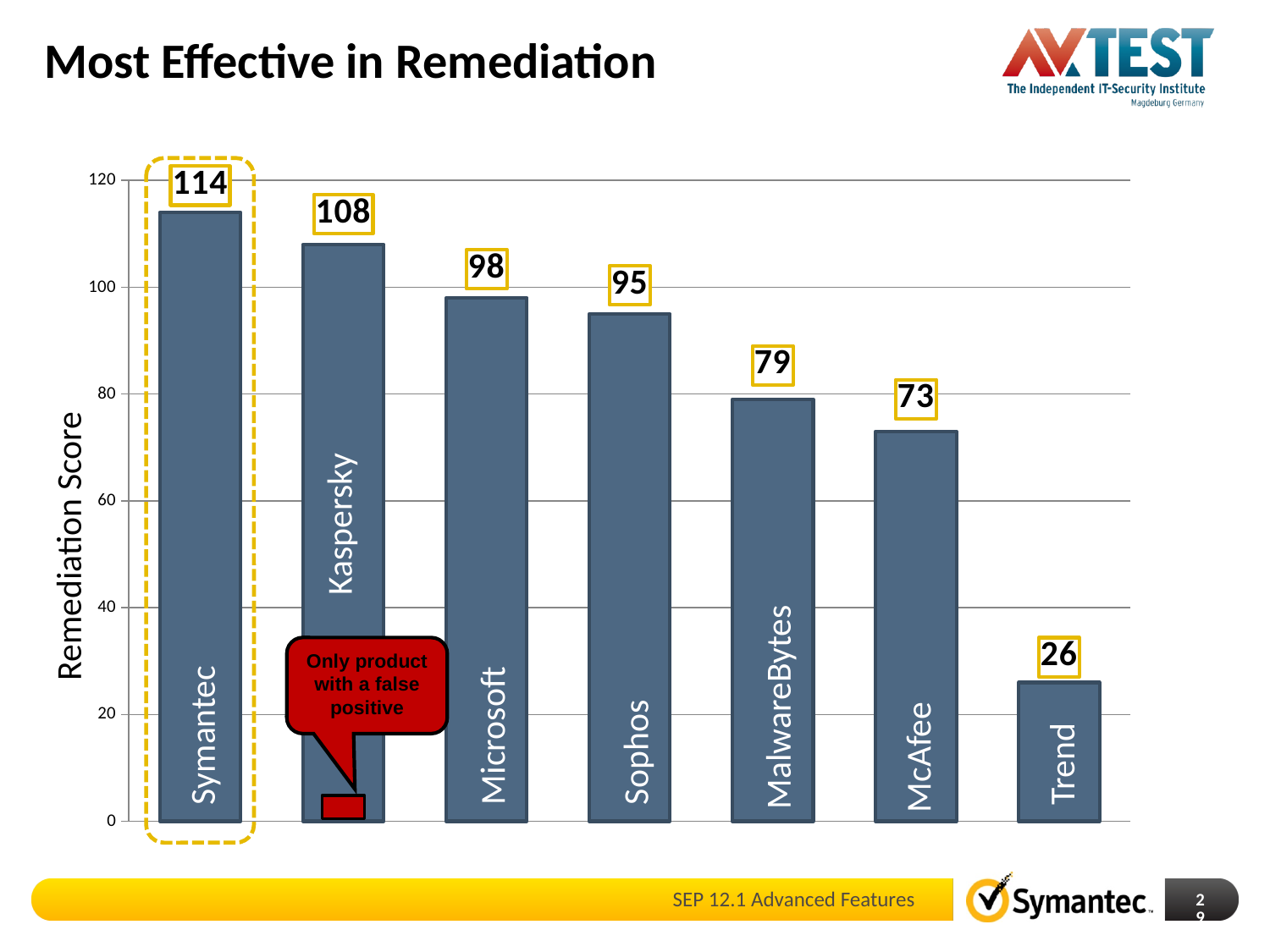
How many products are shown in the chart? 7 What is the difference between the remediation scores of Microsoft and McAfee? 25 What is the remediation score for Trend? 26 What type of chart is shown on the slide? bar chart What is the remediation score for Symantec? 114 Which product is noted as the only product with a false positive? Kaspersky Which has a higher remediation score, Sophos or MalwareBytes? Sophos Which product has the highest remediation score? Symantec What is the remediation score for Kaspersky? 108 What is the difference between the remediation scores of Symantec and Kaspersky? 6 Which product has the lowest remediation score? Trend Is the remediation score for McAfee greater or less than 80? less